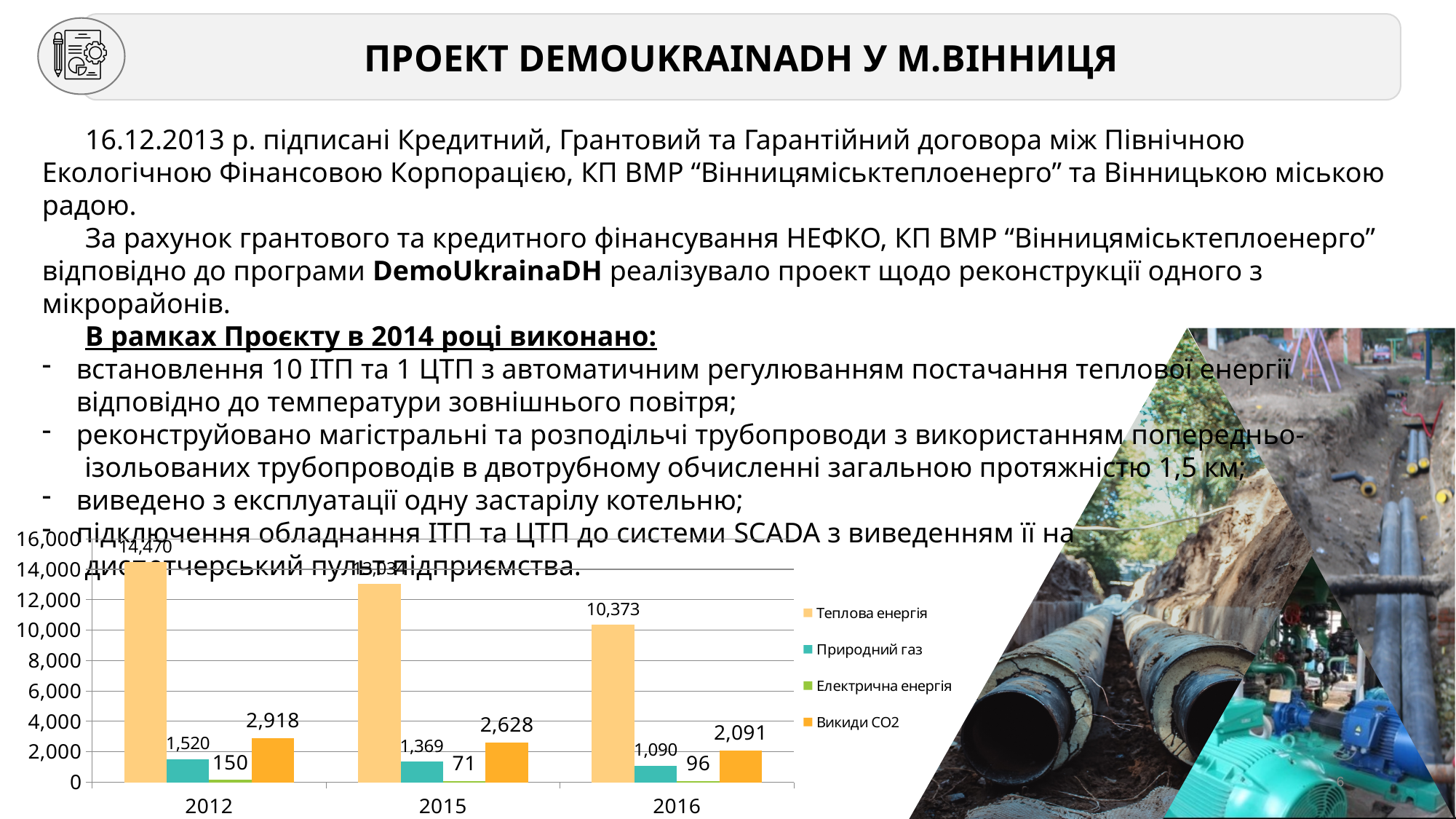
What is the value of Природний газ for 2015? 1,369 In which year is Викиди CO2 highest? 2012 What is the value of Теплова енергія for 2012? 14,470 What is the value of Електрична енергія for 2012? 150 How many series does the chart legend list? 4 What is the difference between Природний газ in 2012 and in 2016? 430 What type of chart is shown on the slide? bar chart What is the value of Викиди CO2 for 2016? 2,091 Is the value for Теплова енергія in 2015 greater or less than 12,000? greater How many year categories are shown on the x axis of the chart? 3 Which is larger: Електрична енергія in 2015 or in 2016? 2016 In which year is Теплова енергія lowest? 2016